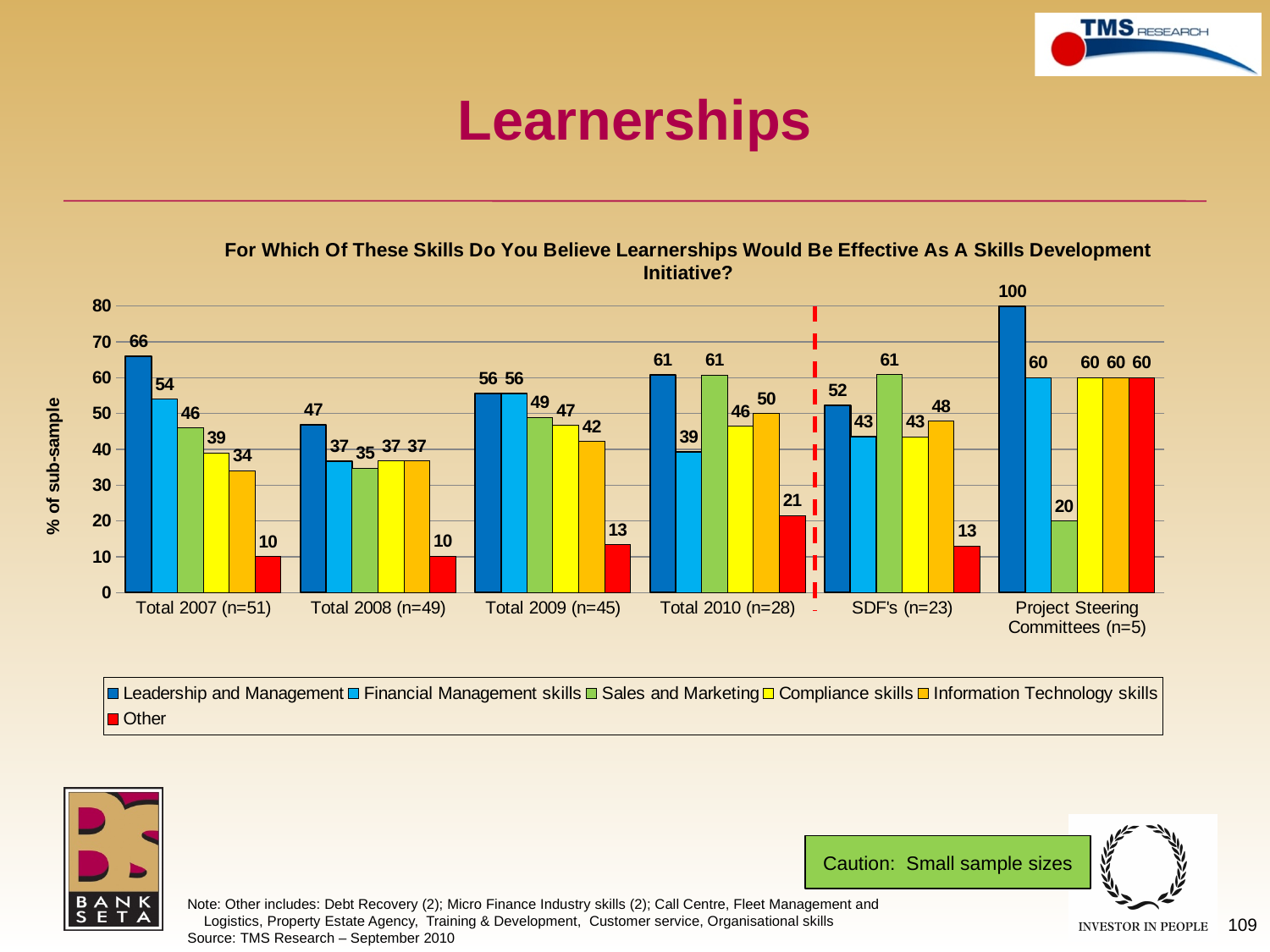
Which category has the highest value for Leadership and Management? Project Steering Committees (n=5) What is the value for Other in Total 2010 (n=28)? 21 Which is larger in Total 2010 (n=28): Financial Management skills or Information Technology skills? Information Technology skills What is the value for Leadership and Management in Total 2007 (n=51)? 66 What is the difference between Leadership and Management and Financial Management skills in Total 2007 (n=51)? 12 How many categories are shown on the x axis? 6 What is the value for Information Technology skills in SDF's (n=23)? 48 Which series has the lowest value in Total 2009 (n=45)? Other What kind of chart is shown on the slide? Bar chart What is the value for Sales and Marketing in Project Steering Committees (n=5)? 20 How many series does the legend list? 6 What is the label of the y axis? % of sub-sample